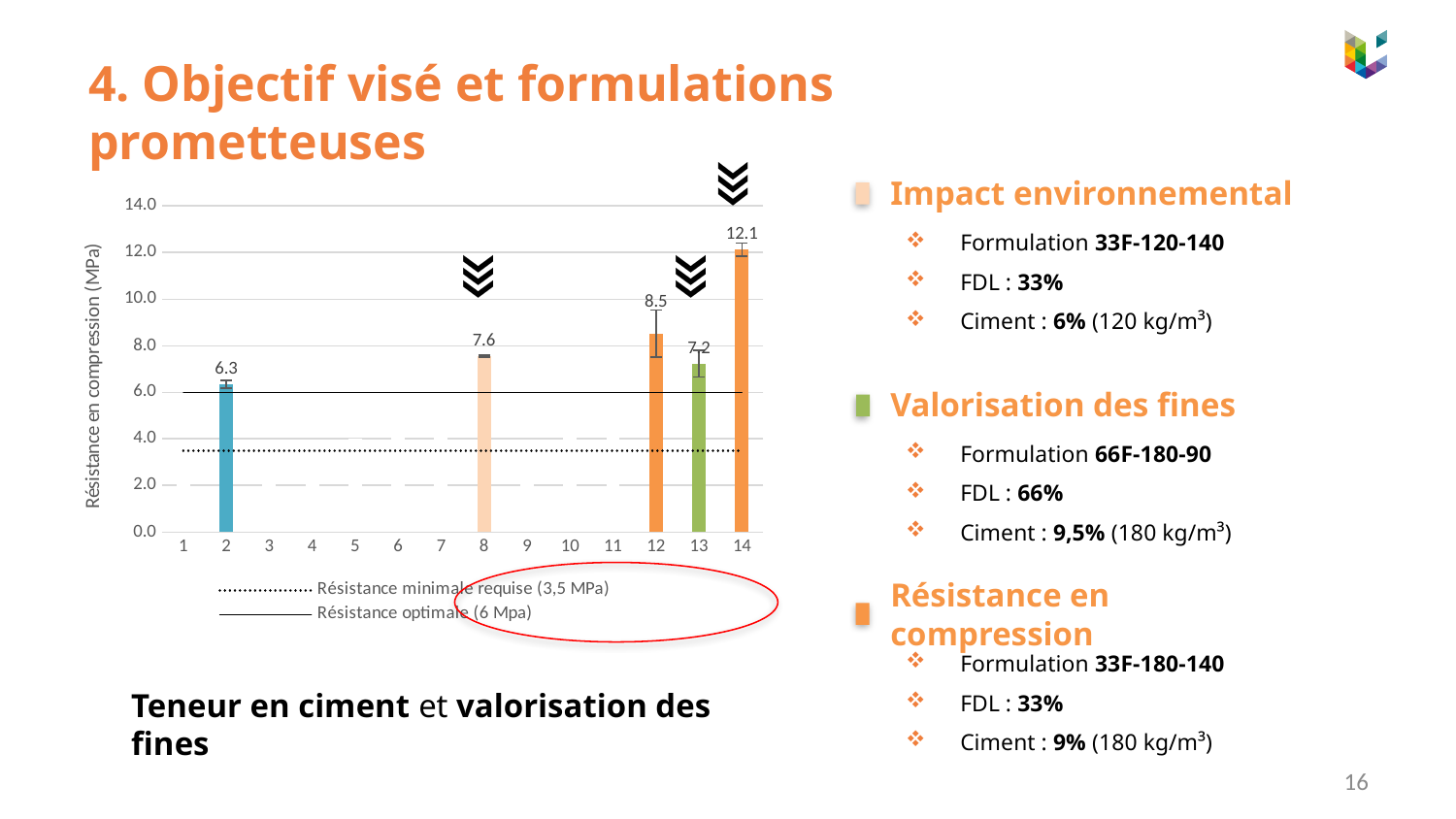
Is the value of the bar at category 13 greater or less than 6.0? greater Which category has the lowest bar? 2 How many bars are plotted on the chart? 5 What is the value of the bar at category 2? 6.3 What type of chart is shown on the slide? Bar chart Which is larger, the bar at category 12 or the bar at category 13? Category 12 What is the difference between the bar at category 14 and the bar at category 12? 3.6 What is the value of the bar at category 14? 12.1 What is the label of the y-axis? Résistance en compression (MPa) Which category has the highest bar? 14 What is the value of the bar at category 12? 8.5 What is the value of the bar at category 8? 7.6